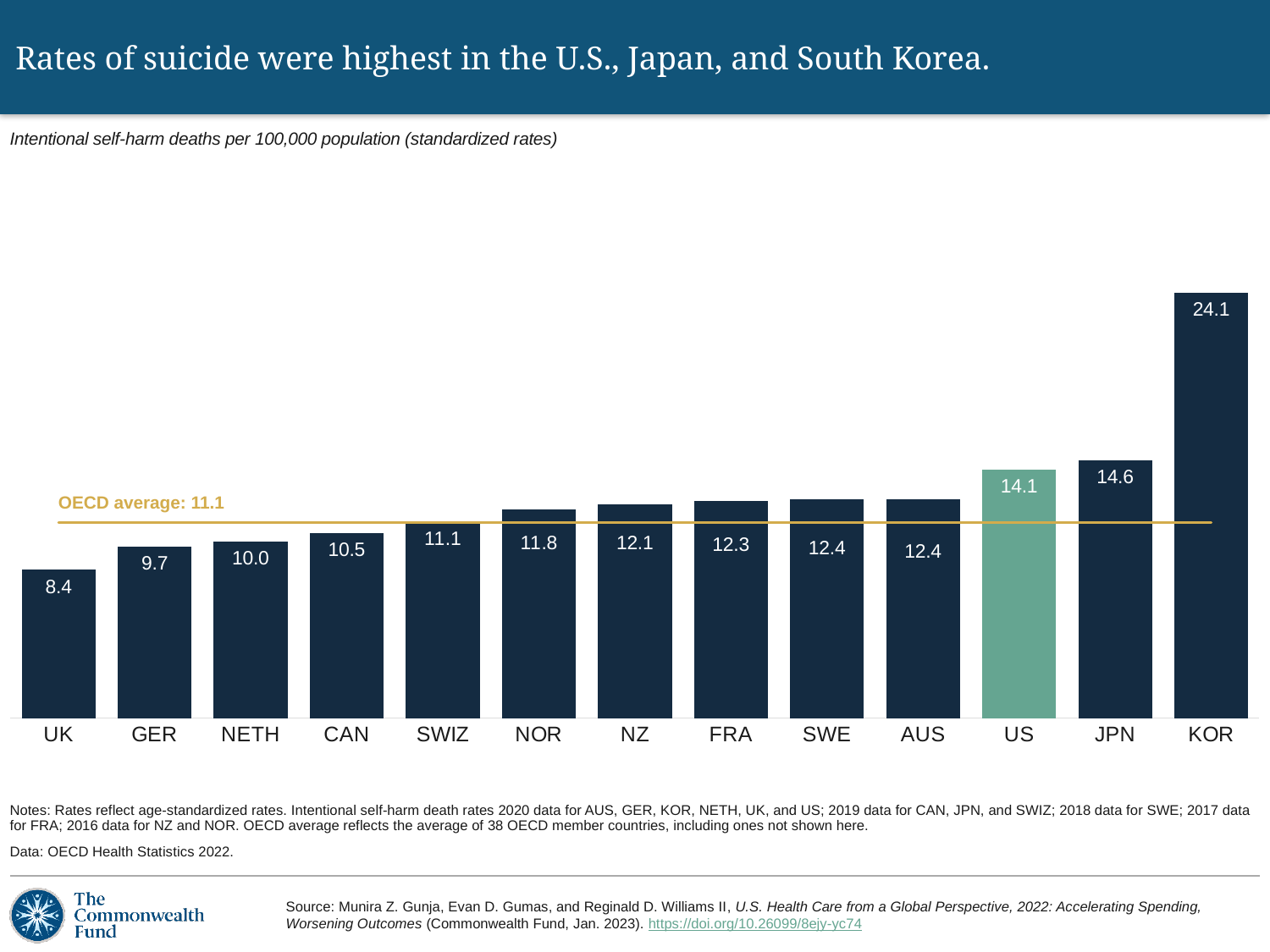
What is the intentional self-harm death rate per 100,000 population for the US? 14.1 What is the difference between the values for the US and the UK? 5.7 Do the values generally rise or fall moving from left to right along the x axis? Rise What is the value shown for the UK? 8.4 Which country has the lowest intentional self-harm death rate on the chart? UK What is the value shown for KOR? 24.1 What is the difference between the values for KOR and JPN? 9.5 Which has a higher value, NOR or CAN? NOR What kind of chart is shown on the slide? Bar chart How many countries are shown on the chart? 13 What OECD average is marked on the chart? 11.1 Which country has the highest intentional self-harm death rate on the chart? KOR